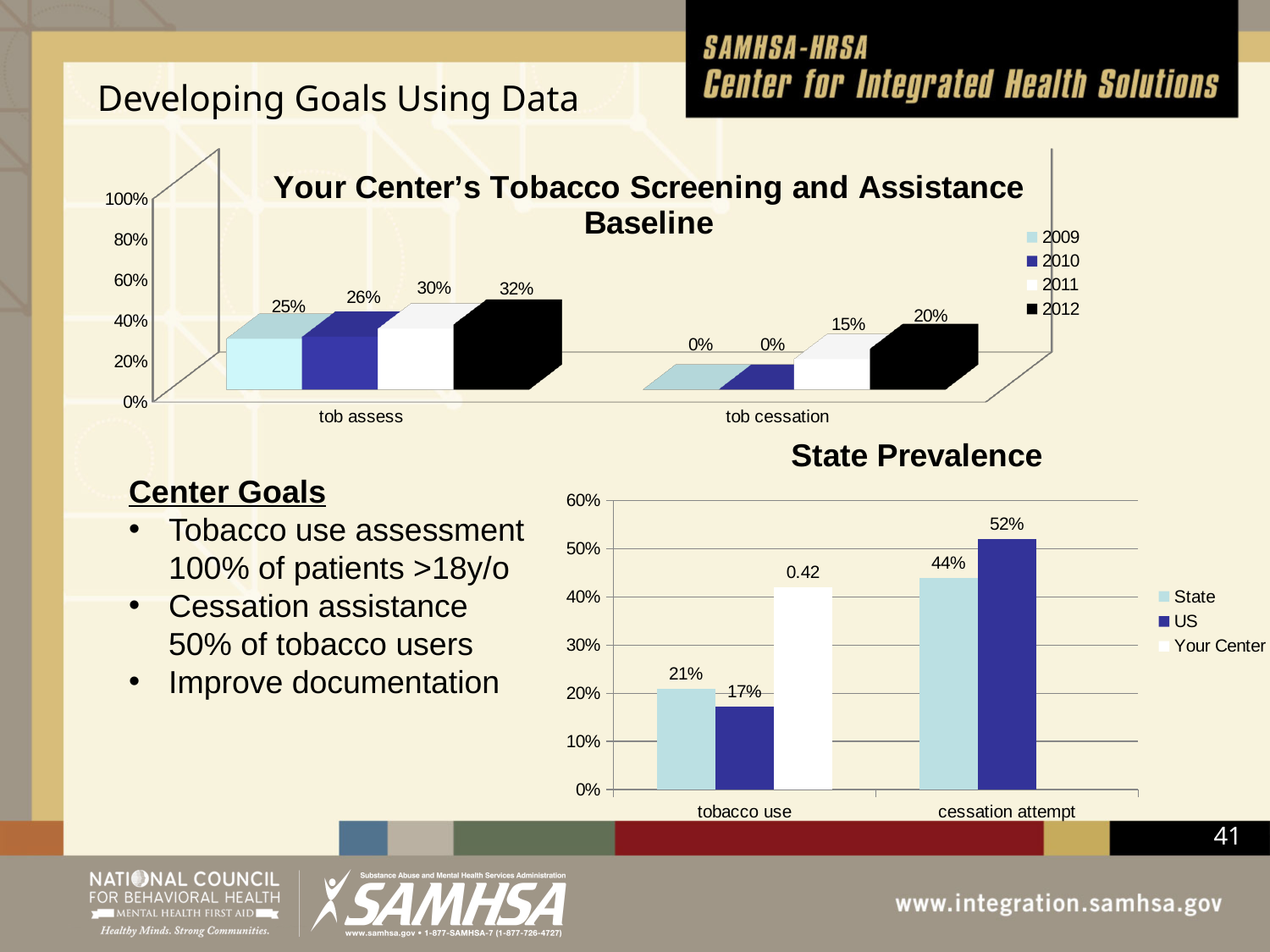
In the 'State Prevalence' chart, is the State value for tobacco use larger or smaller than the US value? larger In the 'Your Center's Tobacco Screening and Assistance Baseline' chart, what is the value for 2012 in the tob assess category? 32% In the 'Your Center's Tobacco Screening and Assistance Baseline' chart, do the tob cessation values rise or fall from 2009 to 2012? rise In the 'State Prevalence' chart, what is the difference between the US and State values for cessation attempt? 8% In the 'Your Center's Tobacco Screening and Assistance Baseline' chart, how many series does the legend list? 4 In the 'Your Center's Tobacco Screening and Assistance Baseline' chart, what is the value for 2011 in the tob cessation category? 15% In the 'State Prevalence' chart, what is the value for Your Center in the tobacco use category? 0.42 In the 'State Prevalence' chart, which series has the highest value for cessation attempt? US In the 'Your Center's Tobacco Screening and Assistance Baseline' chart, what is the difference between the 2012 and 2009 values for tob assess? 7% In the 'State Prevalence' chart, what is the value for US in the tobacco use category? 17% What kind of chart is the 'State Prevalence' chart? bar chart In the 'Your Center's Tobacco Screening and Assistance Baseline' chart, which year has the lowest value for tob assess? 2009